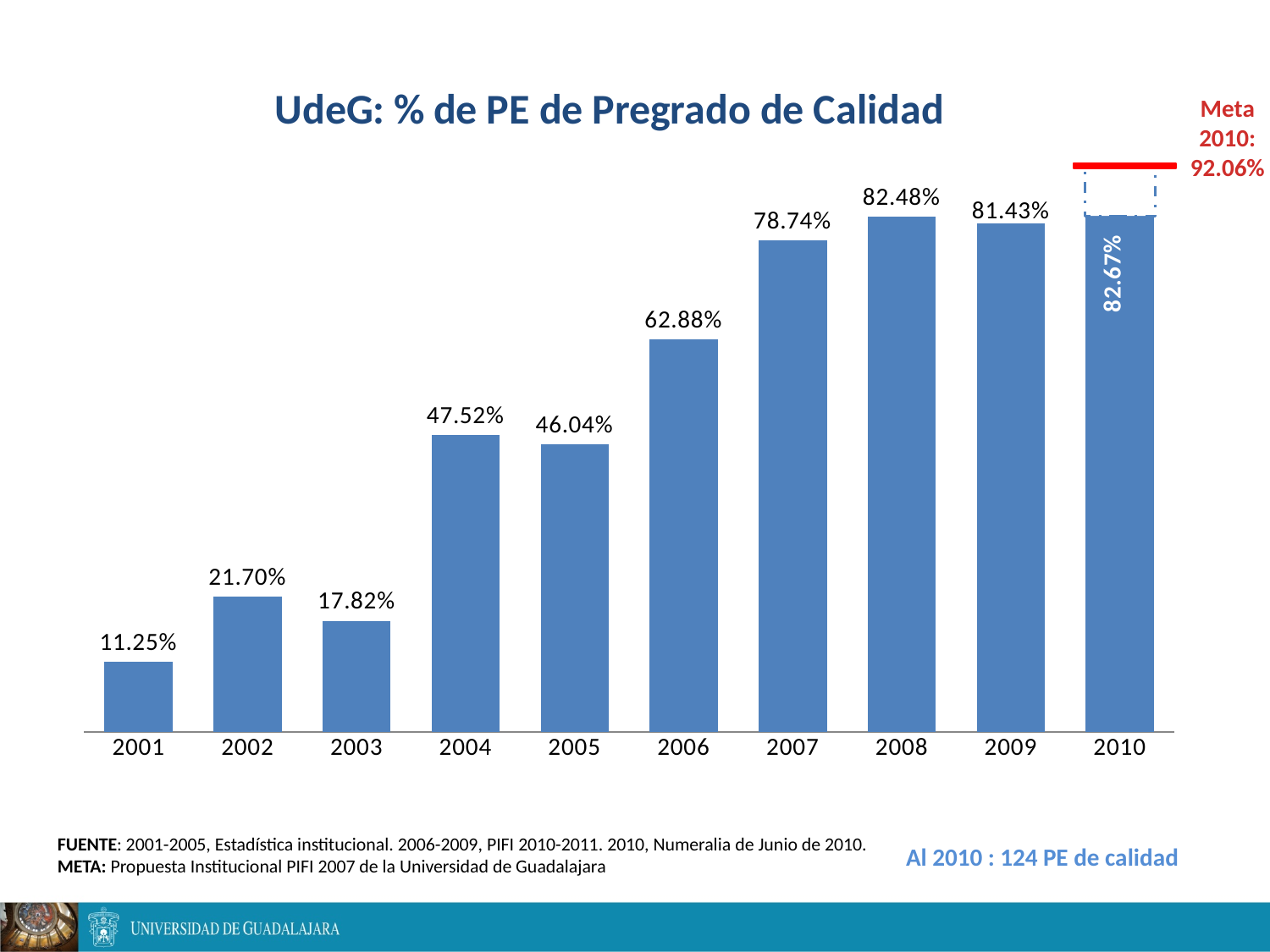
What is the value for 2010? 82.67% How many years are shown on the x axis? 10 Do the values generally rise or fall from 2001 to 2010? rise Which year has the highest value? 2010 Which year has the lowest value? 2001 What is the difference between the values for 2004 and 2005? 1.48% What is the value for 2001? 11.25% What is the value for 2006? 62.88% What is the title of the chart? UdeG: % de PE de Pregrado de Calidad Which is larger, the value for 2002 or the value for 2003? 2002 What is the Meta 2010 value marked by the red line? 92.06% What kind of chart is this? bar chart